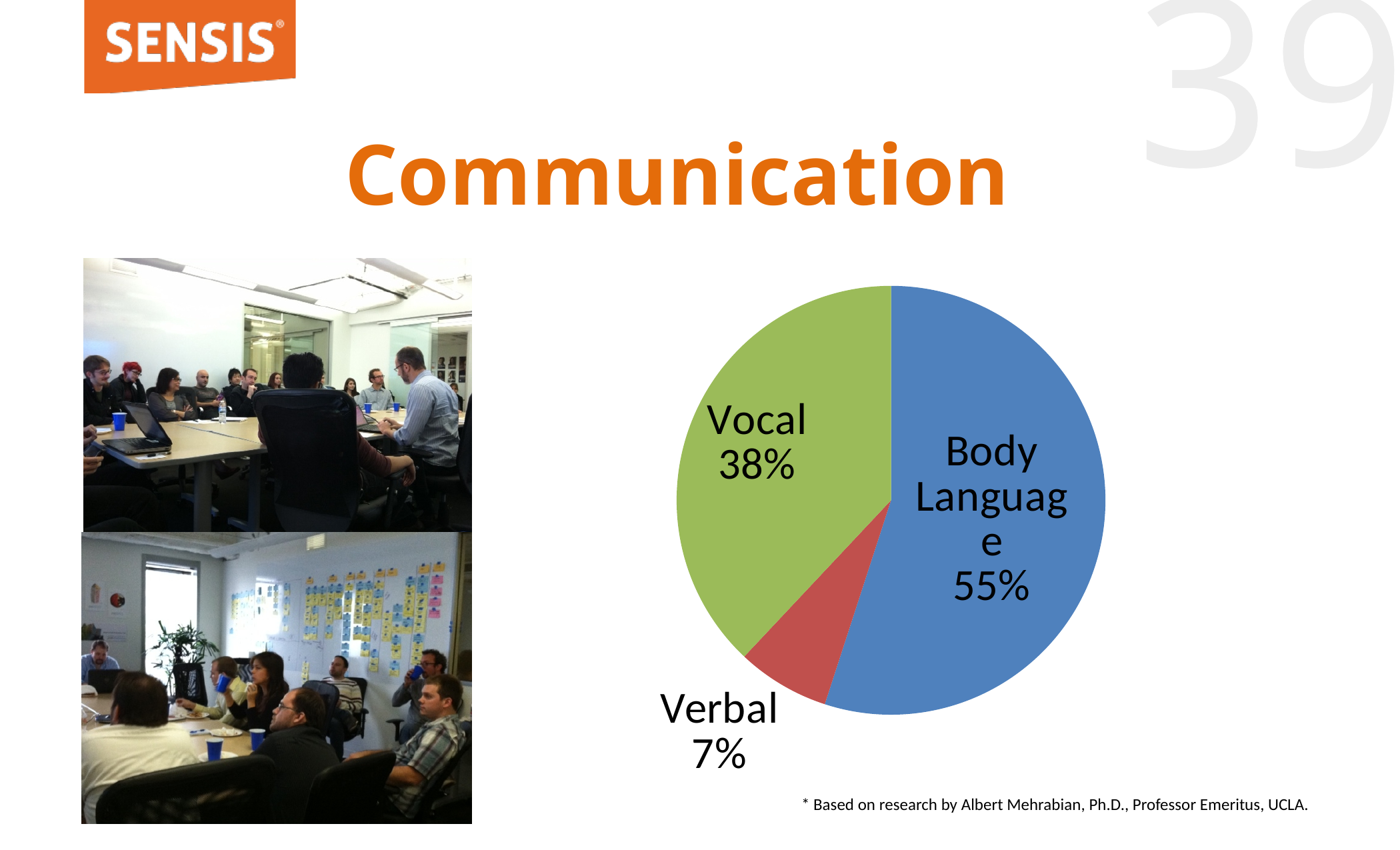
What colour is the Body Language slice of the pie chart? Blue What kind of chart is shown on the slide? Pie chart What share of the pie chart is Verbal? 7% What share of the pie chart is Body Language? 55% How many slices does the pie chart have? 3 What is the difference between the Body Language and Vocal shares? 17% Which slice of the pie chart is the smallest? Verbal What is the difference between the Vocal and Verbal shares? 31% What share of the pie chart is Vocal? 38% Which slice of the pie chart is the largest? Body Language What colour is the Verbal slice of the pie chart? Red Which is larger, the Vocal share or the Verbal share? Vocal